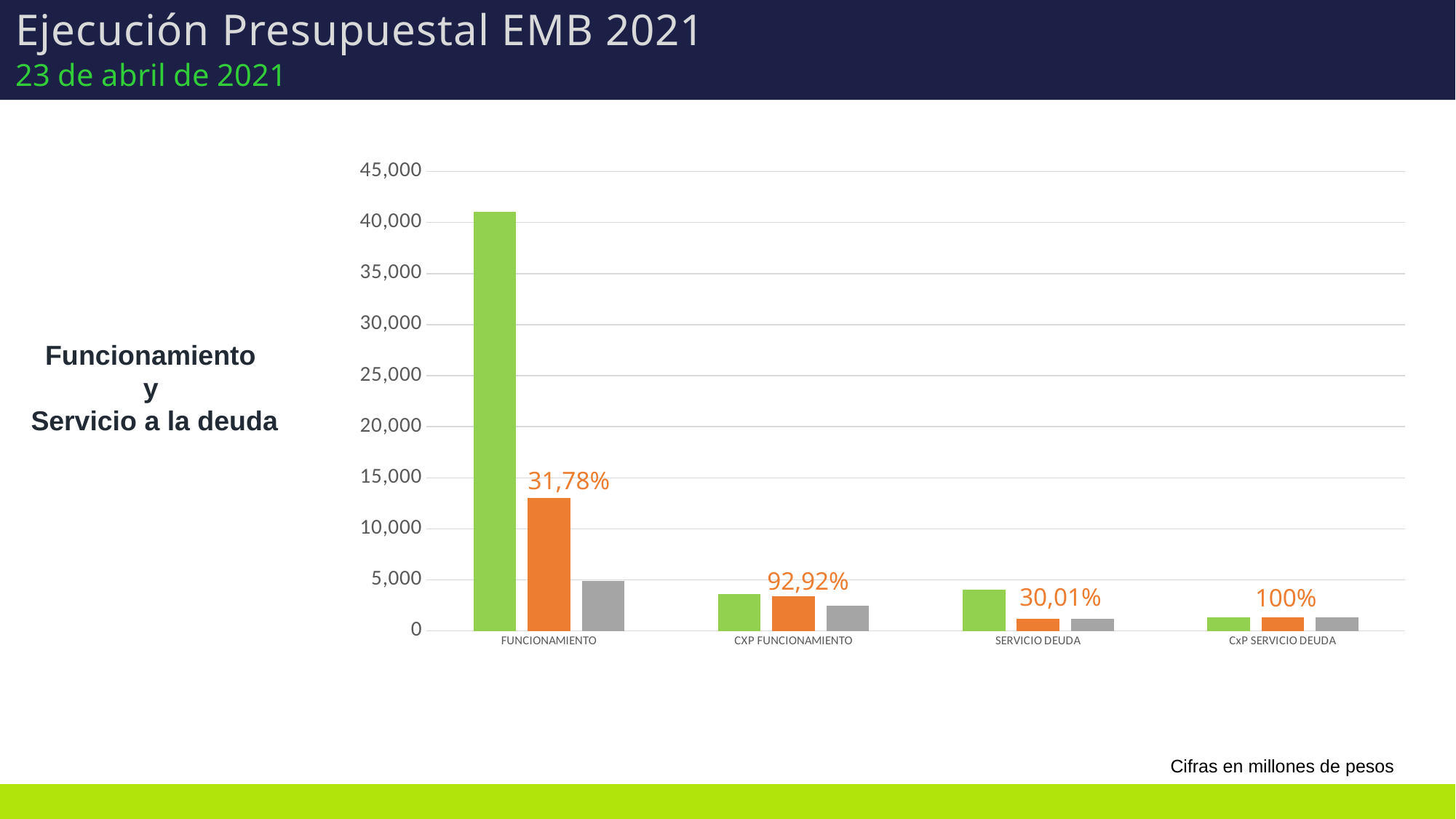
What percentage label is shown for SERVICIO DEUDA? 30,01% According to the note on the slide, in what units are the figures expressed? millones de pesos What percentage label is shown for CxP SERVICIO DEUDA? 100% Which category has the highest percentage label? CxP SERVICIO DEUDA How many categories are shown on the x axis? 4 What percentage label is shown for CXP FUNCIONAMIENTO? 92,92% What percentage label is shown for FUNCIONAMIENTO? 31,78% Which category has the lowest percentage label? SERVICIO DEUDA Is the value of the green bar for FUNCIONAMIENTO greater or less than 35,000? greater Which category has the tallest green bar? FUNCIONAMIENTO What kind of chart is shown on the slide? bar chart Is the value of the orange bar for FUNCIONAMIENTO greater or less than 10,000? greater